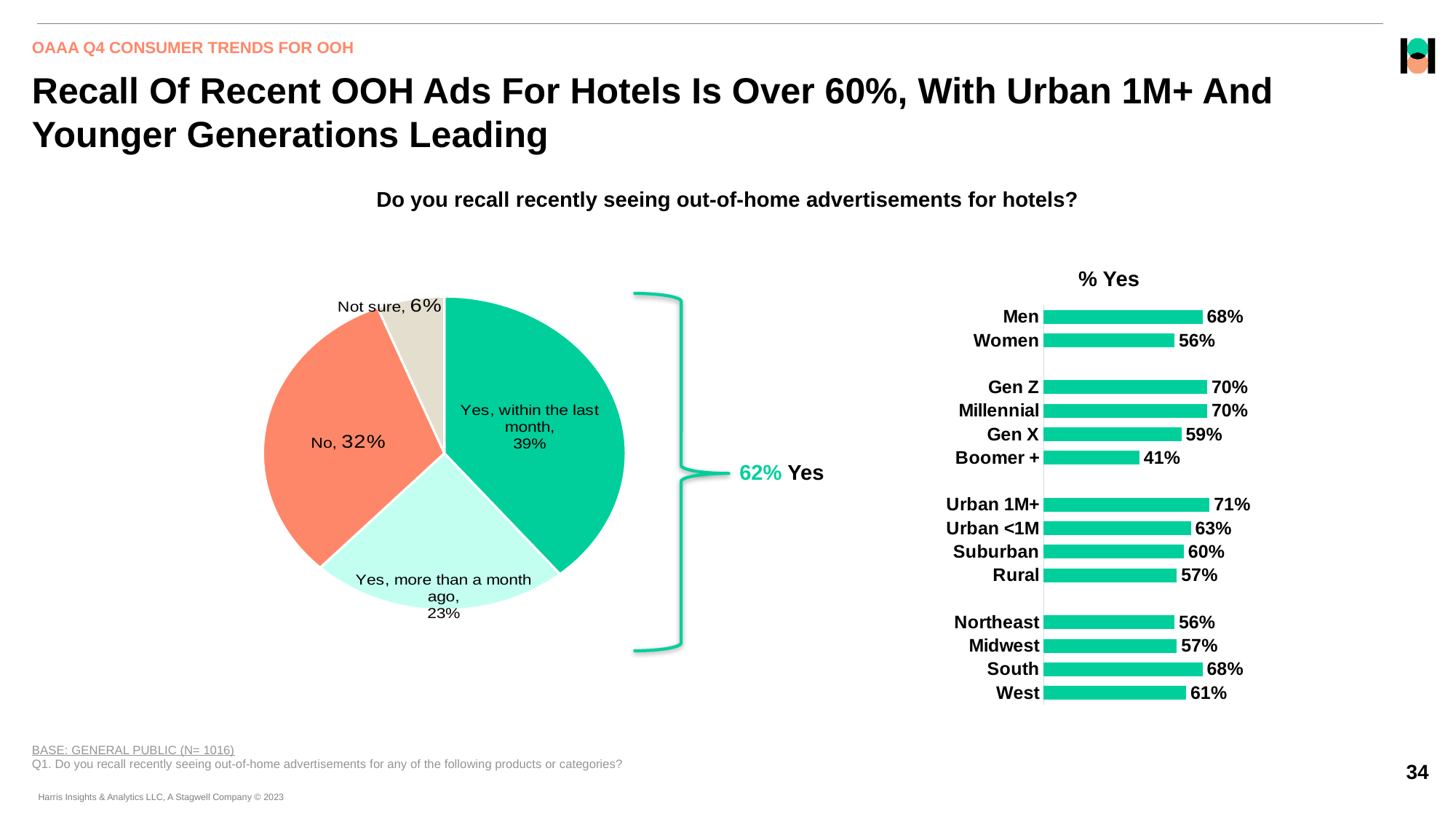
In the "% Yes" bar chart, what is the value for Boomer +? 41% In the pie chart, how many slices are there? 4 In the "% Yes" bar chart, what is the value for Urban 1M+? 71% In the "% Yes" bar chart, what is the difference between Men and Women? 12% In the "% Yes" bar chart, which is larger, South or Northeast? South In the pie chart, what is the combined share of the two "Yes" slices? 62% What kind of chart is the "% Yes" chart on the right? Bar chart In the pie chart, which slice is the smallest? Not sure In the "% Yes" bar chart, which category has the highest value? Urban 1M+ In the pie chart, what share of respondents answered "No"? 32% In the "% Yes" bar chart, which category has the lowest value? Boomer + In the pie chart, what share answered "Yes, within the last month"? 39%